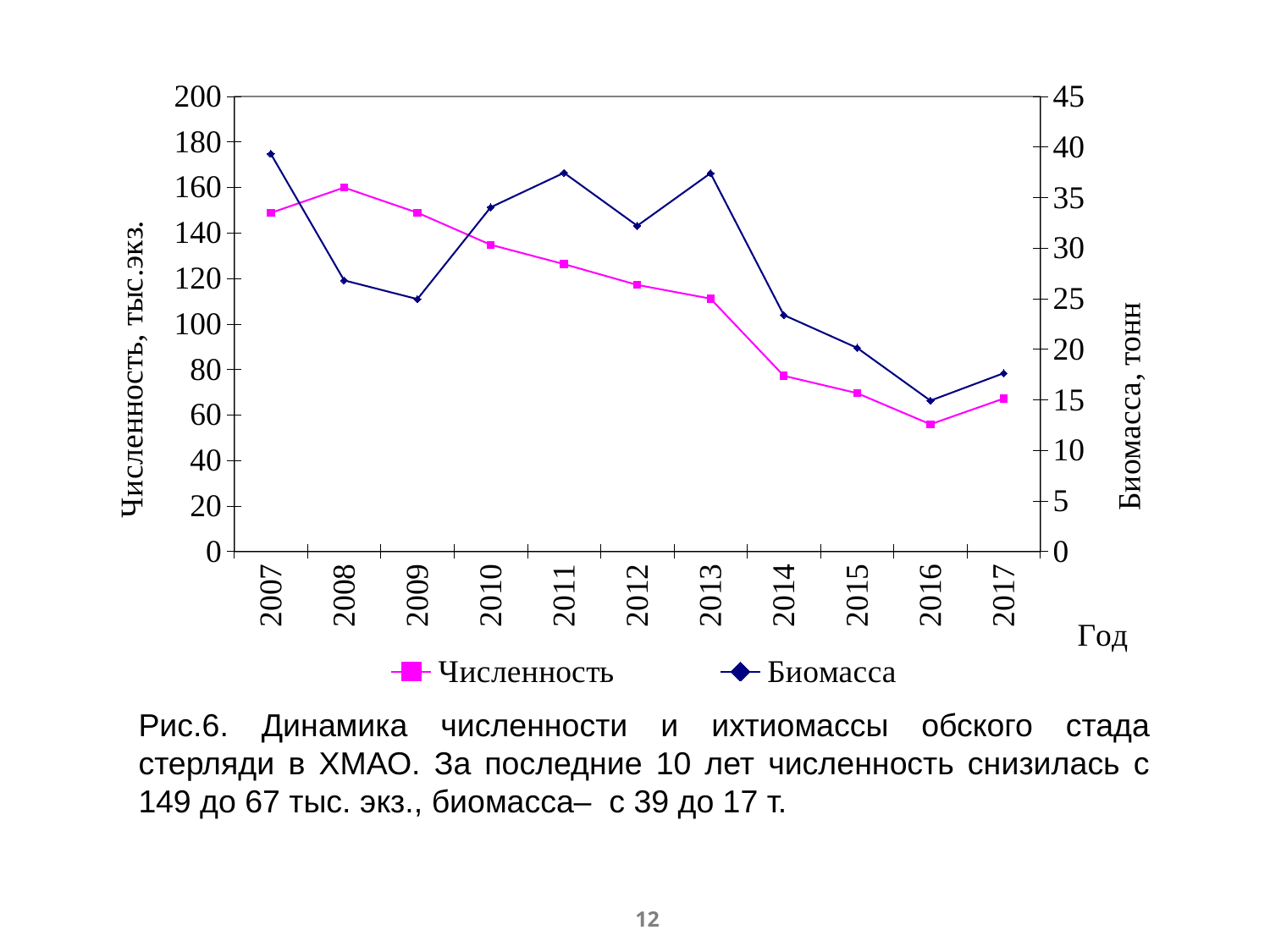
How many years are plotted along the x axis? 11 What kind of chart is shown on the slide? line chart How many series does the legend list? 2 By how much did Биомасса decrease from 2007 to 2017? 22 т In which year is Численность highest? 2008 Is the value for Биомасса in 2008 greater or less than 30? less By how much did Численность decrease from 2007 to 2017? 82 тыс. экз. According to the slide, what was the value of Численность in 2017? 67 тыс. экз. In which year is Численность lowest? 2016 According to the slide, what was the value of Численность in 2007? 149 тыс. экз. According to the slide, what was the value of Биомасса in 2007? 39 т Is the value for Численность in 2014 greater or less than 100? less